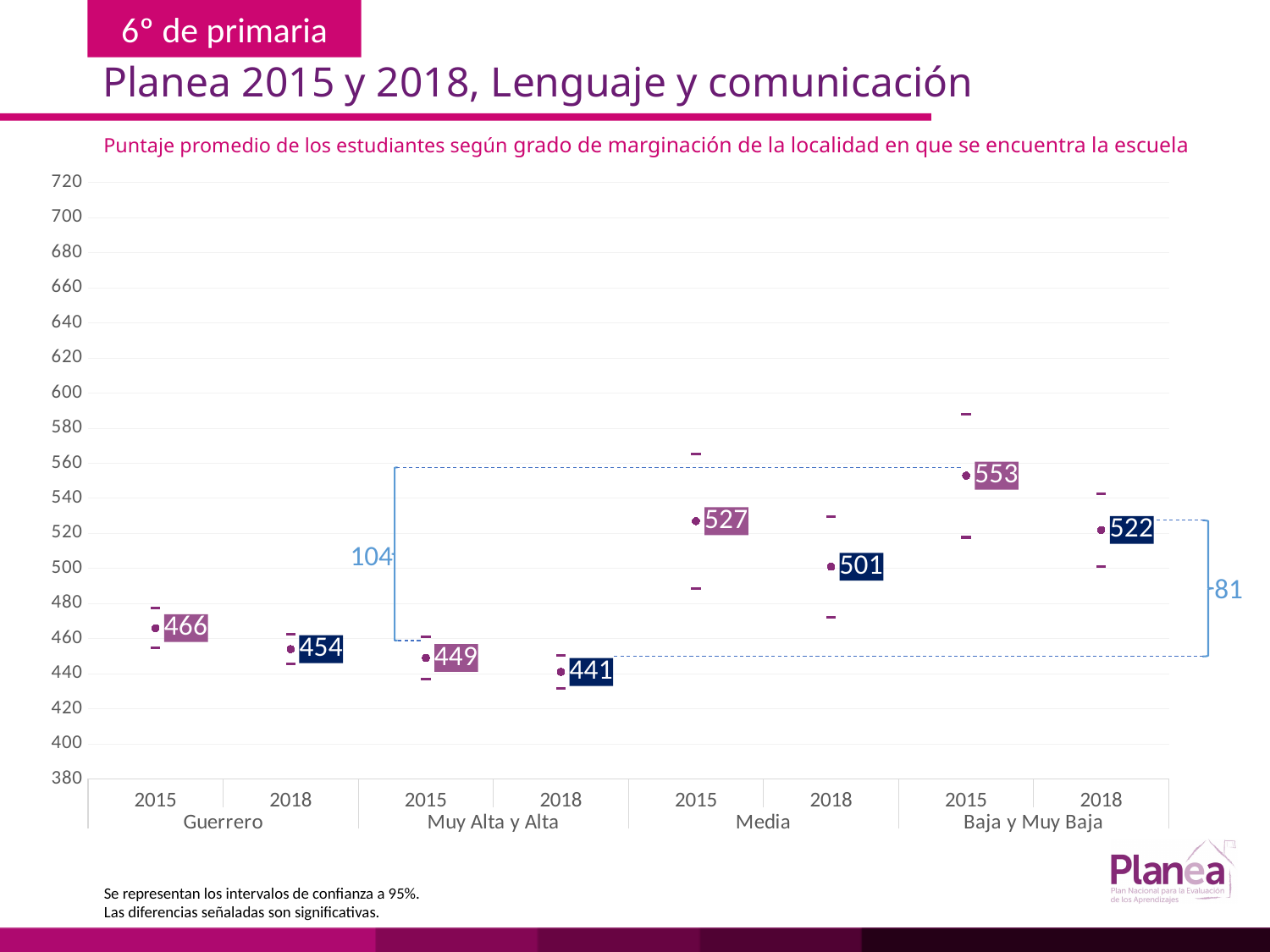
Did the average score for Guerrero rise or fall from 2015 to 2018? fall What is the difference between the 2015 and 2018 scores for Media? 26 What is the difference between the 2015 scores of Baja y Muy Baja and Muy Alta y Alta? 104 Which group and year has the highest average score? Baja y Muy Baja, 2015 What is the average score for Guerrero in 2015? 466 Which group and year has the lowest average score? Muy Alta y Alta, 2018 How many marginalization groups are shown on the x axis? 4 What is the average score for Muy Alta y Alta in 2018? 441 Is the 2018 score for Baja y Muy Baja greater or less than 500? greater Which is larger, the 2018 score for Guerrero or the 2018 score for Muy Alta y Alta? Guerrero What is the average score for Baja y Muy Baja in 2015? 553 What is the average score for Media in 2018? 501